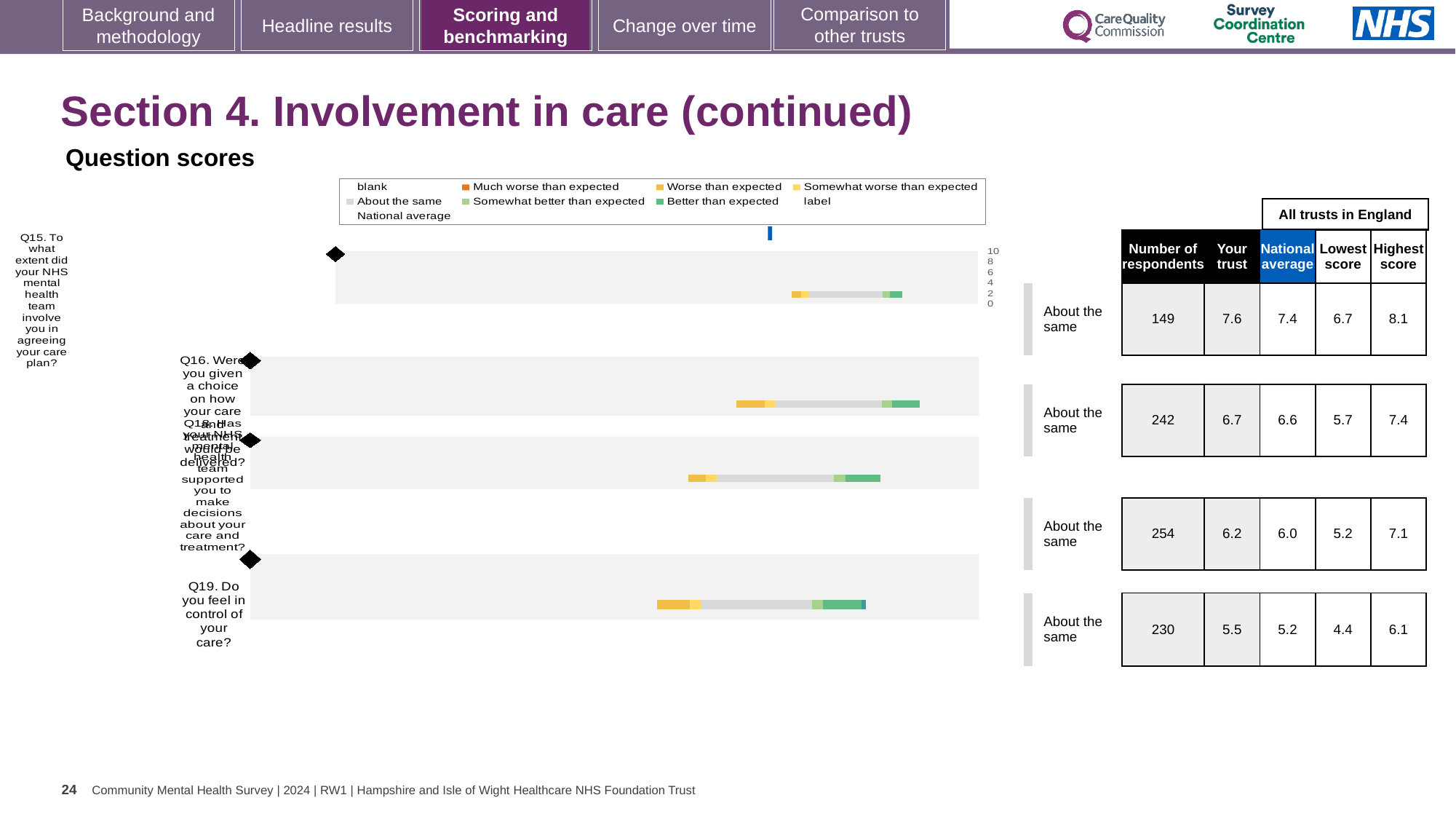
For Q15, which is larger: the 'Your trust' score or the national average? Your trust What is the highest score among all trusts in England for Q16? 7.4 Which question has the lowest 'Your trust' score? Q19 How many respondents answered Q16? 242 What type of chart is used to show the question scores? Bar chart What is the national average score for Q15 (involvement in agreeing your care plan)? 7.4 How many questions are shown on the chart? 4 Do the 'Your trust' scores rise or fall going from Q15 down to Q19? Fall What is the difference between the 'Your trust' score and the national average for Q19? 0.3 Which question has the highest 'Your trust' score? Q15 What is the 'Your trust' score for Q19 (Do you feel in control of your care?)? 5.5 What is the lowest score among all trusts in England for Q18? 5.2